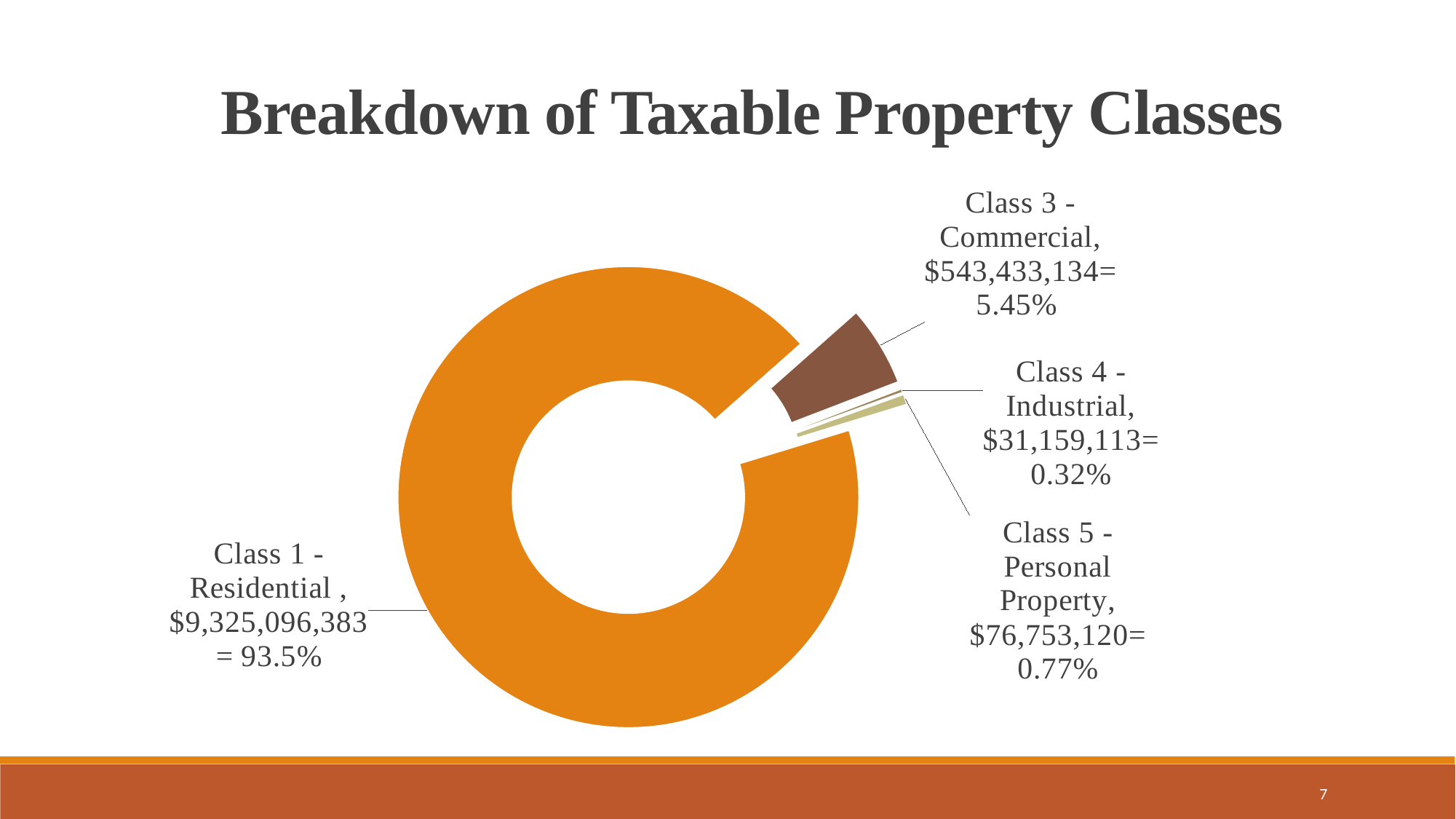
Which has a larger taxable value, Class 3 - Commercial or Class 5 - Personal Property? Class 3 - Commercial What is the taxable value shown for Class 3 - Commercial? $543,433,134 What is the taxable value shown for Class 5 - Personal Property? $76,753,120 Which property class has the smallest share of the chart? Class 4 - Industrial What is the difference in taxable value between Class 5 - Personal Property and Class 4 - Industrial? $45,594,007 What share of the chart does Class 3 - Commercial represent? 5.45% What is the taxable value shown for Class 4 - Industrial? $31,159,113 Which property class has the largest share of the chart? Class 1 - Residential What share of the chart does Class 1 - Residential represent? 93.5% What share of the chart does Class 4 - Industrial represent? 0.32% How many property classes are shown in the chart? 4 What is the taxable value shown for Class 1 - Residential? $9,325,096,383